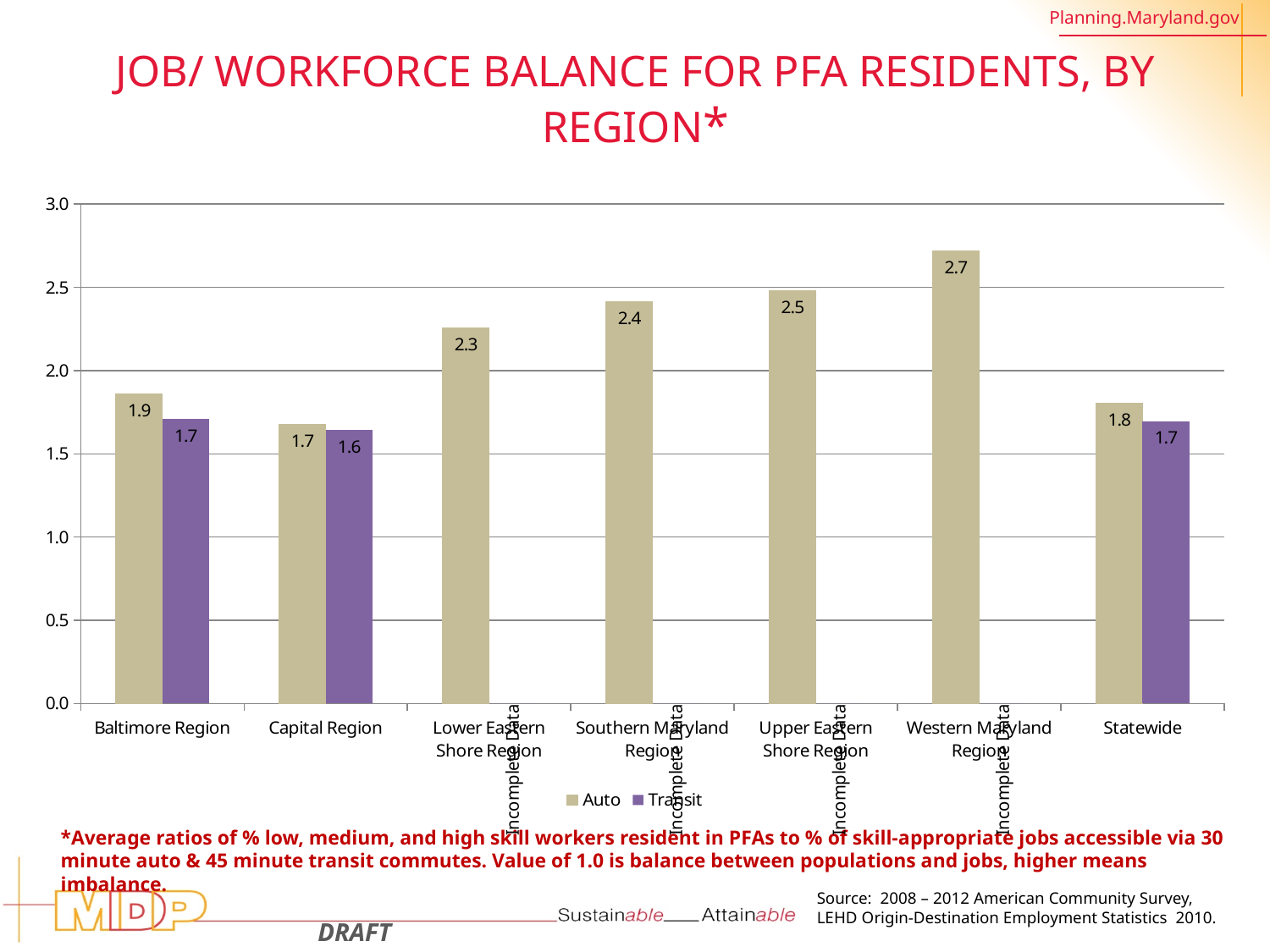
What is the Transit value for the Capital Region? 1.6 What is the Auto value for Statewide? 1.8 Which region has the highest Auto value? Western Maryland Region What label is shown in place of the Transit bar for the Southern Maryland Region? Incomplete Data Which is larger, the Auto value for the Upper Eastern Shore Region or the Auto value for the Southern Maryland Region? Upper Eastern Shore Region What kind of chart is shown on the slide? Bar chart Is the Auto value for the Lower Eastern Shore Region greater or less than 2.0? greater What is the difference between the Auto and Transit values for the Baltimore Region? 0.2 What is the Auto value for the Western Maryland Region? 2.7 Which category has the lowest Auto value? Capital Region How many series does the legend list? 2 How many categories are shown on the x axis? 7